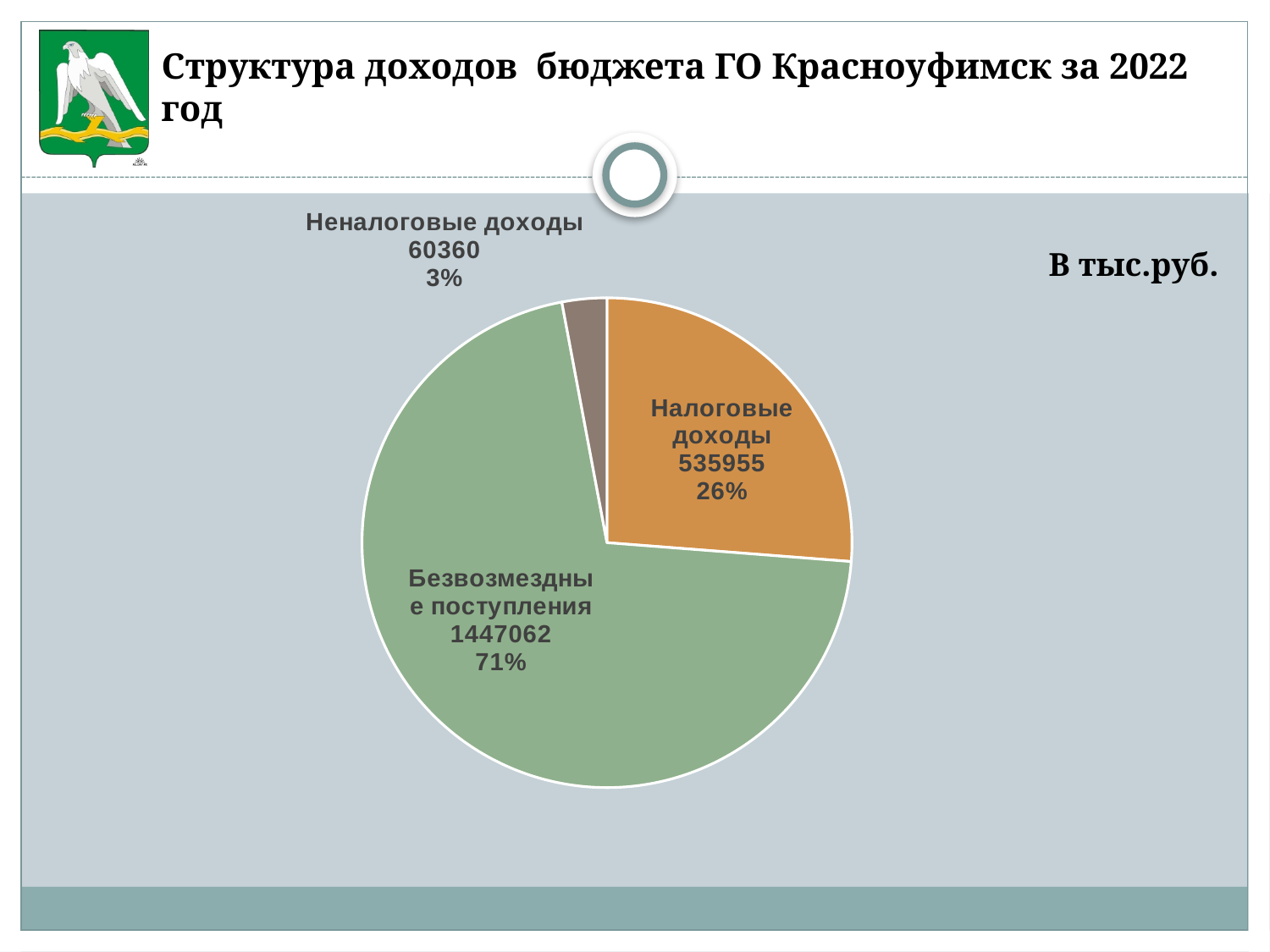
What is the value for Налоговые доходы? 535955 Which category has the smallest value? Неналоговые доходы What is the value for Безвозмездные поступления? 1447062 What share of the pie does Налоговые доходы represent? 26% What share of the pie does Неналоговые доходы represent? 3% What kind of chart is shown on the slide? pie chart What is the value for Неналоговые доходы? 60360 Which category has the largest value? Безвозмездные поступления What share of the pie does Безвозмездные поступления represent? 71% What is the difference between Безвозмездные поступления and Налоговые доходы? 911107 Which is larger, Налоговые доходы or Неналоговые доходы? Налоговые доходы How many categories are shown in the pie chart? 3